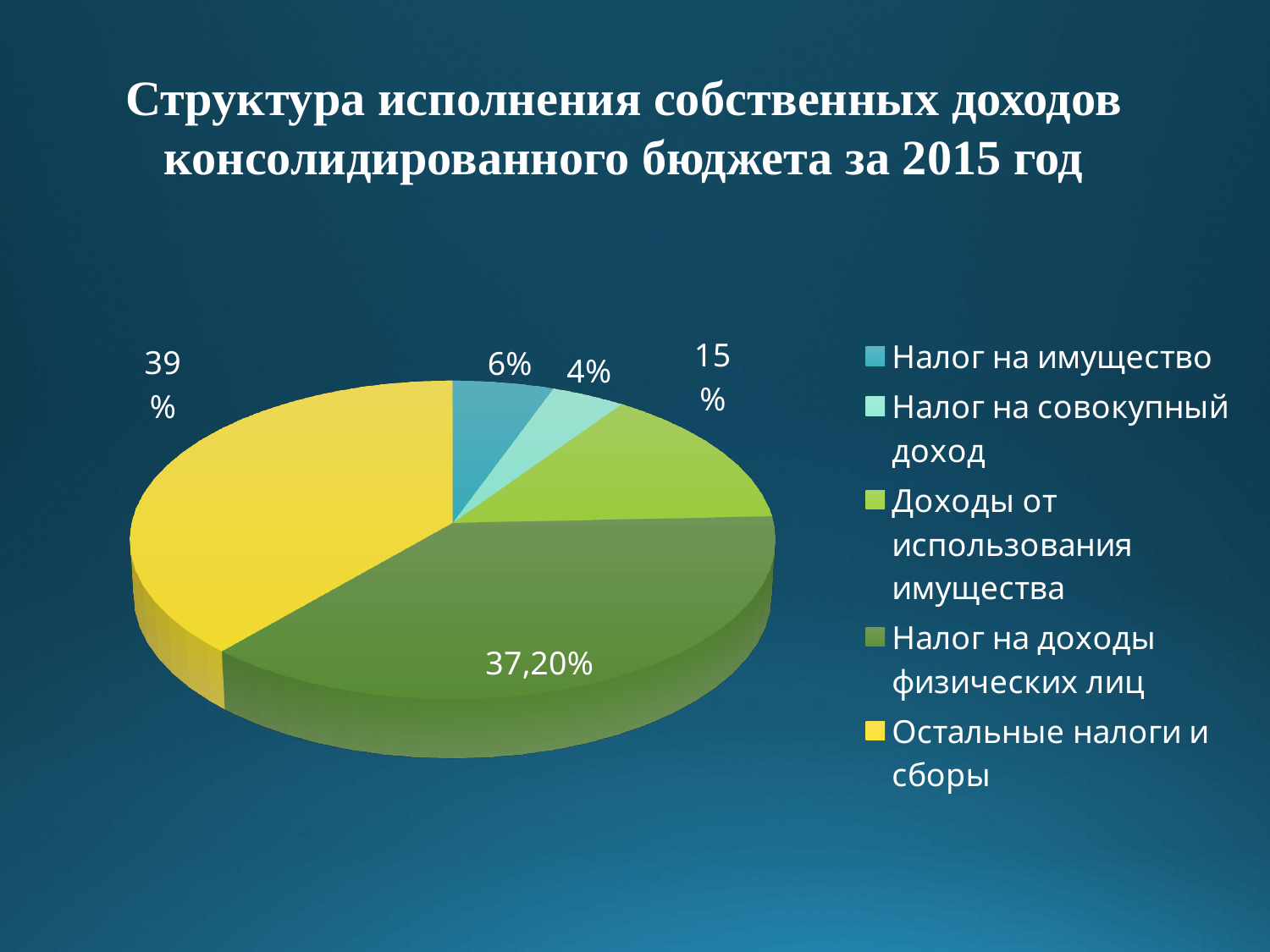
Which is larger: Доходы от использования имущества or Налог на имущество? Доходы от использования имущества What colour is the slice for Остальные налоги и сборы? Yellow What share is shown for Остальные налоги и сборы? 39% What is the value labelled for Налог на доходы физических лиц? 37,20% What is the difference between the shares of Доходы от использования имущества and Налог на имущество? 9% Which category has the largest slice of the pie? Остальные налоги и сборы What type of chart is shown on the slide? Pie chart What share of the pie does Налог на имущество represent? 6% Which category has the smallest slice of the pie? Налог на совокупный доход What is the value shown for Налог на совокупный доход? 4% What percentage is shown for Доходы от использования имущества? 15% How many categories does the pie chart show? 5